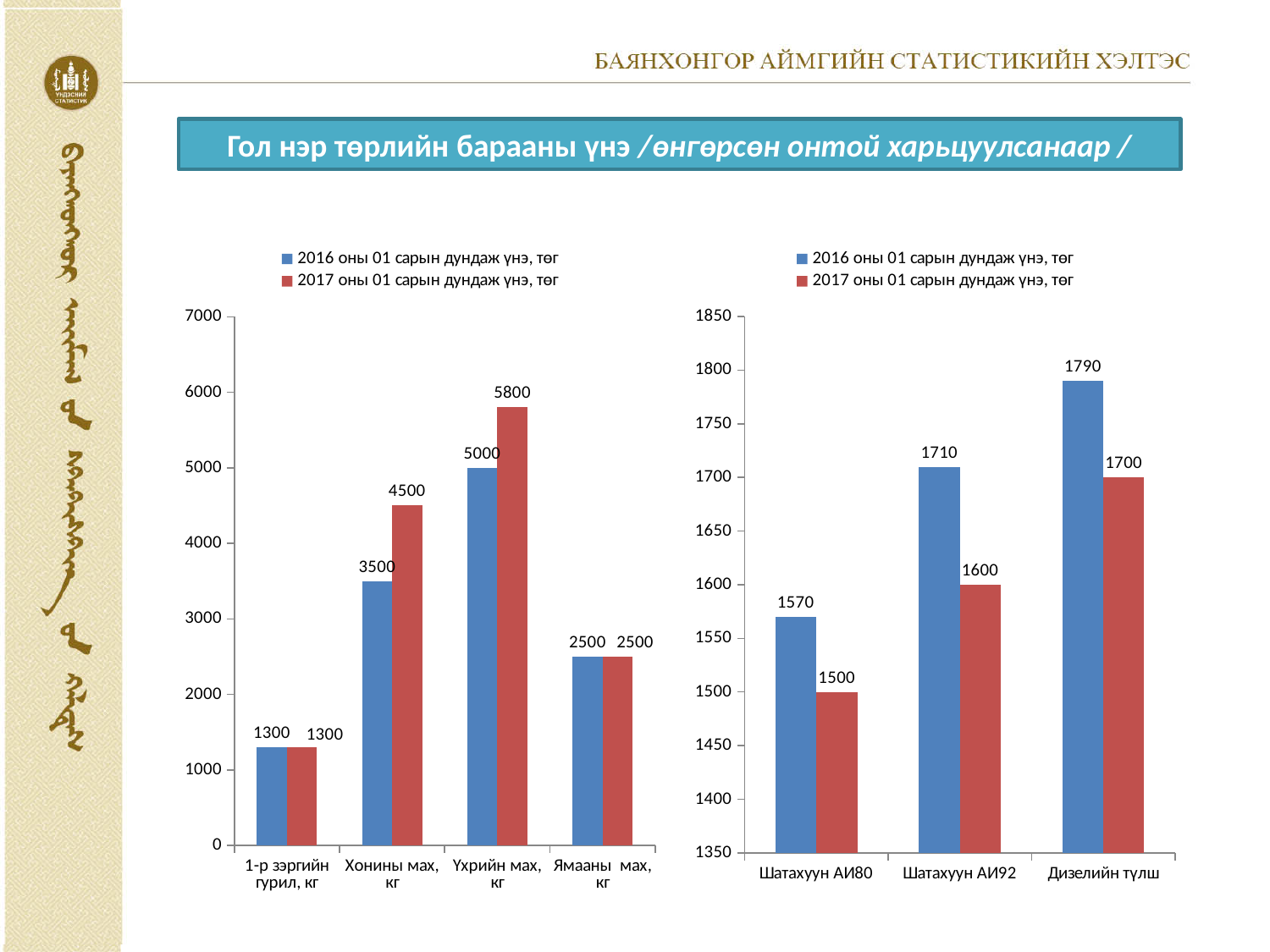
In the right chart, how many series does the legend list? 2 In the right chart, which is larger for Шатахуун АИ92: the 2016 value or the 2017 value? 2016 value In the right chart, what is the difference between the 2016 and 2017 values for Шатахуун АИ92? 110 In the left chart, how many categories are shown on the x axis? 4 In the left chart, what is the 2017 оны 01 сарын дундаж үнэ for Хонины мах, кг? 4500 In the left chart, which category has the lowest 2016 оны 01 сарын дундаж үнэ? 1-р зэргийн гурил, кг In the left chart, what is the 2016 оны 01 сарын дундаж үнэ for Үхрийн мах, кг? 5000 In the left chart, what is the difference between the 2017 and 2016 values for Үхрийн мах, кг? 800 In the right chart, what is the 2017 оны 01 сарын дундаж үнэ for Шатахуун АИ80? 1500 In the right chart, what is the 2016 оны 01 сарын дундаж үнэ for Дизелийн түлш? 1790 In the left chart, which category has the highest 2017 оны 01 сарын дундаж үнэ? Үхрийн мах, кг What type of chart is the right chart? Bar chart